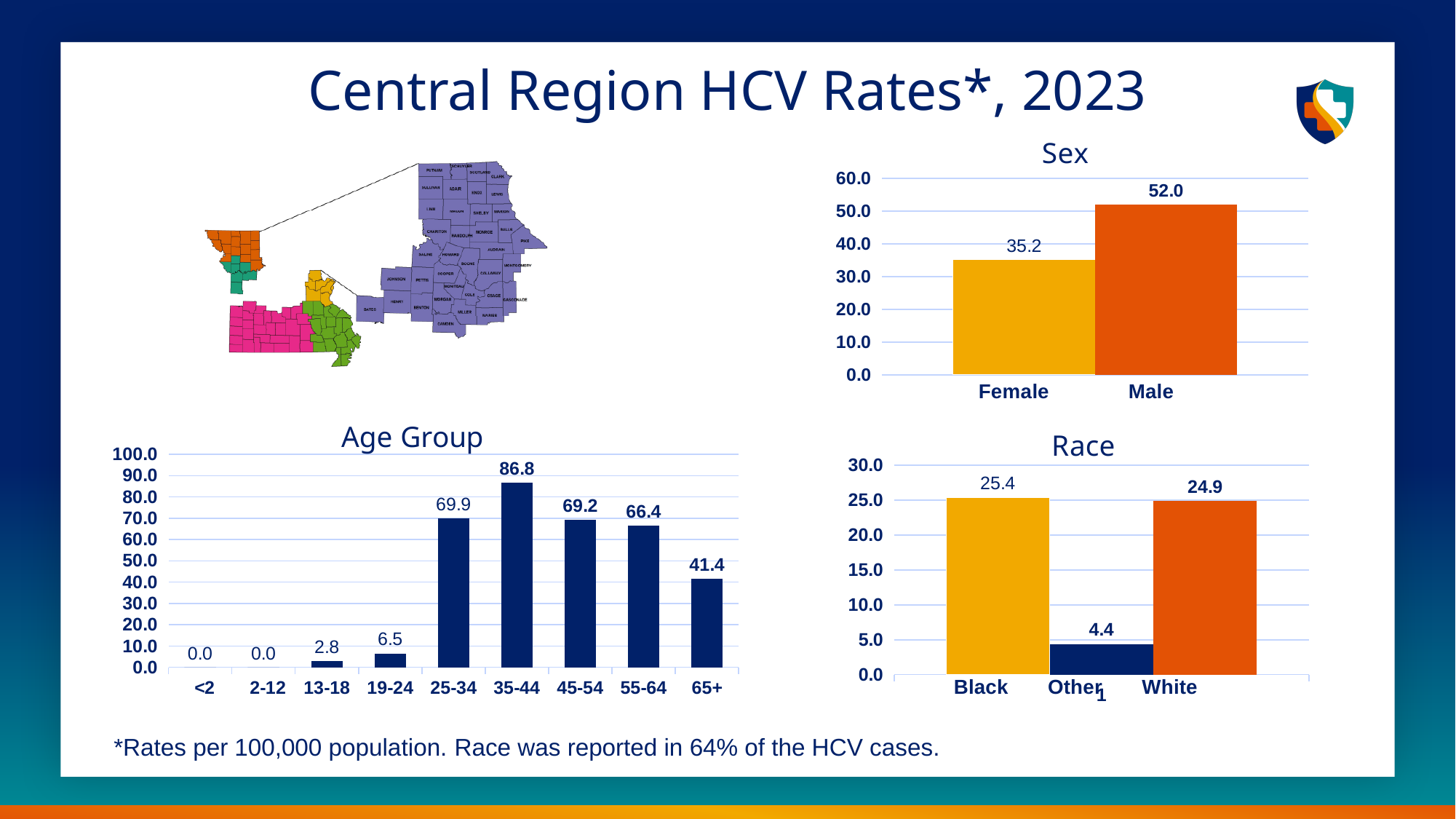
In the Sex chart, what is the HCV rate for Female? 35.2 In the Sex chart, what is the difference between the Male and Female rates? 16.8 In the Race chart, what is the difference between the Black and White rates? 0.5 In the Age Group chart, what is the rate for the 65+ age group? 41.4 In the Age Group chart, which age group has the highest rate? 35-44 In the Sex chart, what is the HCV rate for Male? 52.0 In the Age Group chart, how many age groups are shown on the x axis? 9 In the Age Group chart, what is the rate for the 19-24 age group? 6.5 What type of chart is the Race chart? Bar chart In the Race chart, what is the rate for Other? 4.4 In the Race chart, which category has the lowest rate? Other In the Age Group chart, which is larger, the rate for 25-34 or the rate for 55-64? 25-34